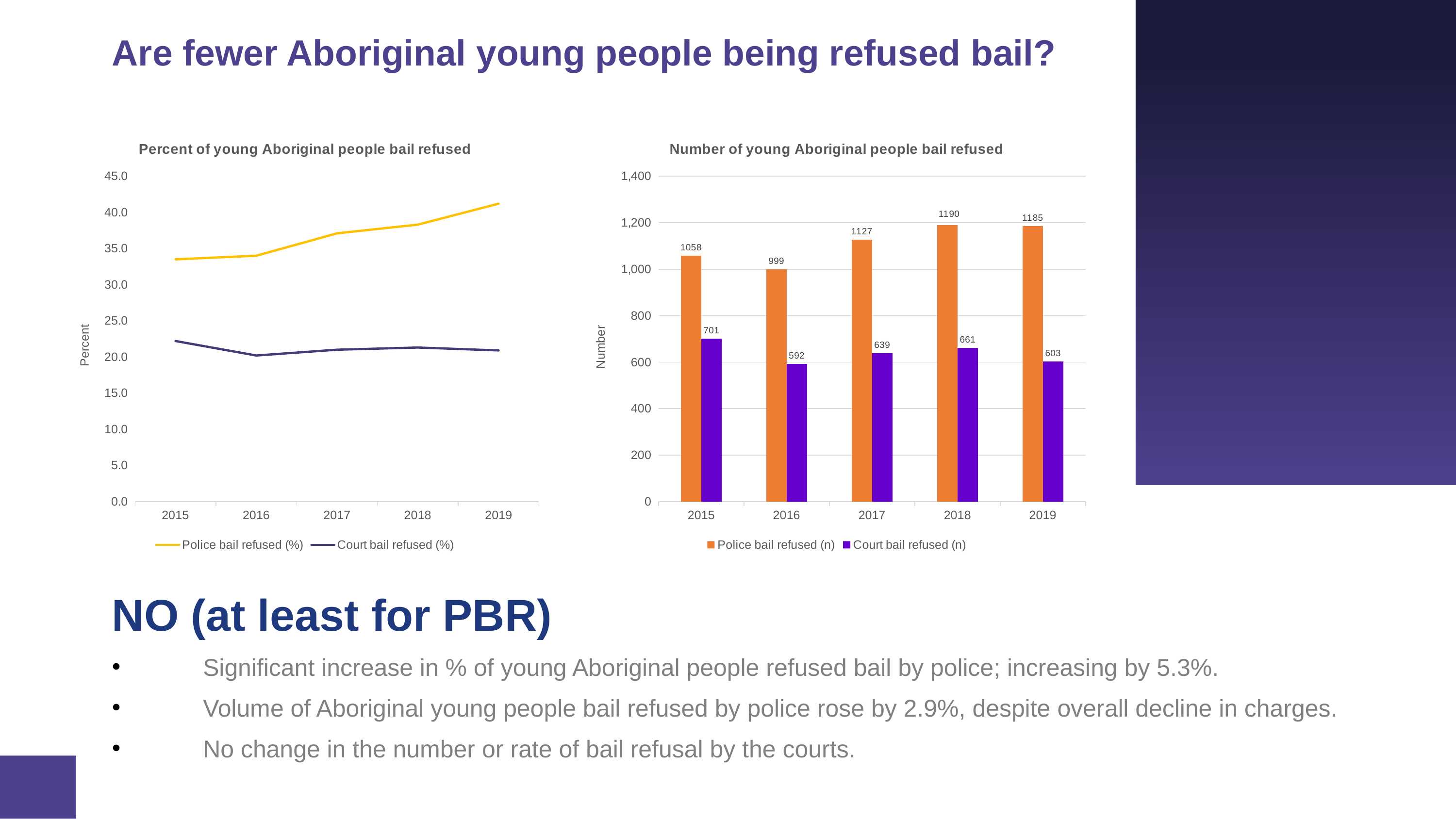
In the 'Number of young Aboriginal people bail refused' chart, which is larger: Court bail refused (n) in 2017 or in 2019? 2017 In the 'Percent of young Aboriginal people bail refused' chart, is the value for Police bail refused (%) in 2019 greater or less than 40.0? greater In the 'Number of young Aboriginal people bail refused' chart, what is the value for Police bail refused (n) in 2018? 1190 What kind of chart is the 'Percent of young Aboriginal people bail refused' chart? Line chart In the 'Number of young Aboriginal people bail refused' chart, which year has the highest Police bail refused (n) value? 2018 How many series does the legend of the 'Percent of young Aboriginal people bail refused' chart list? 2 In the 'Number of young Aboriginal people bail refused' chart, what is the value for Court bail refused (n) in 2016? 592 In the 'Number of young Aboriginal people bail refused' chart, which year has the lowest Court bail refused (n) value? 2016 In the 'Percent of young Aboriginal people bail refused' chart, does the Police bail refused (%) line rise or fall from 2015 to 2019? Rises In the 'Number of young Aboriginal people bail refused' chart, how many years are shown on the x axis? 5 What kind of chart is the 'Number of young Aboriginal people bail refused' chart? Bar chart In the 'Number of young Aboriginal people bail refused' chart, what is the difference between Police bail refused (n) and Court bail refused (n) in 2015? 357